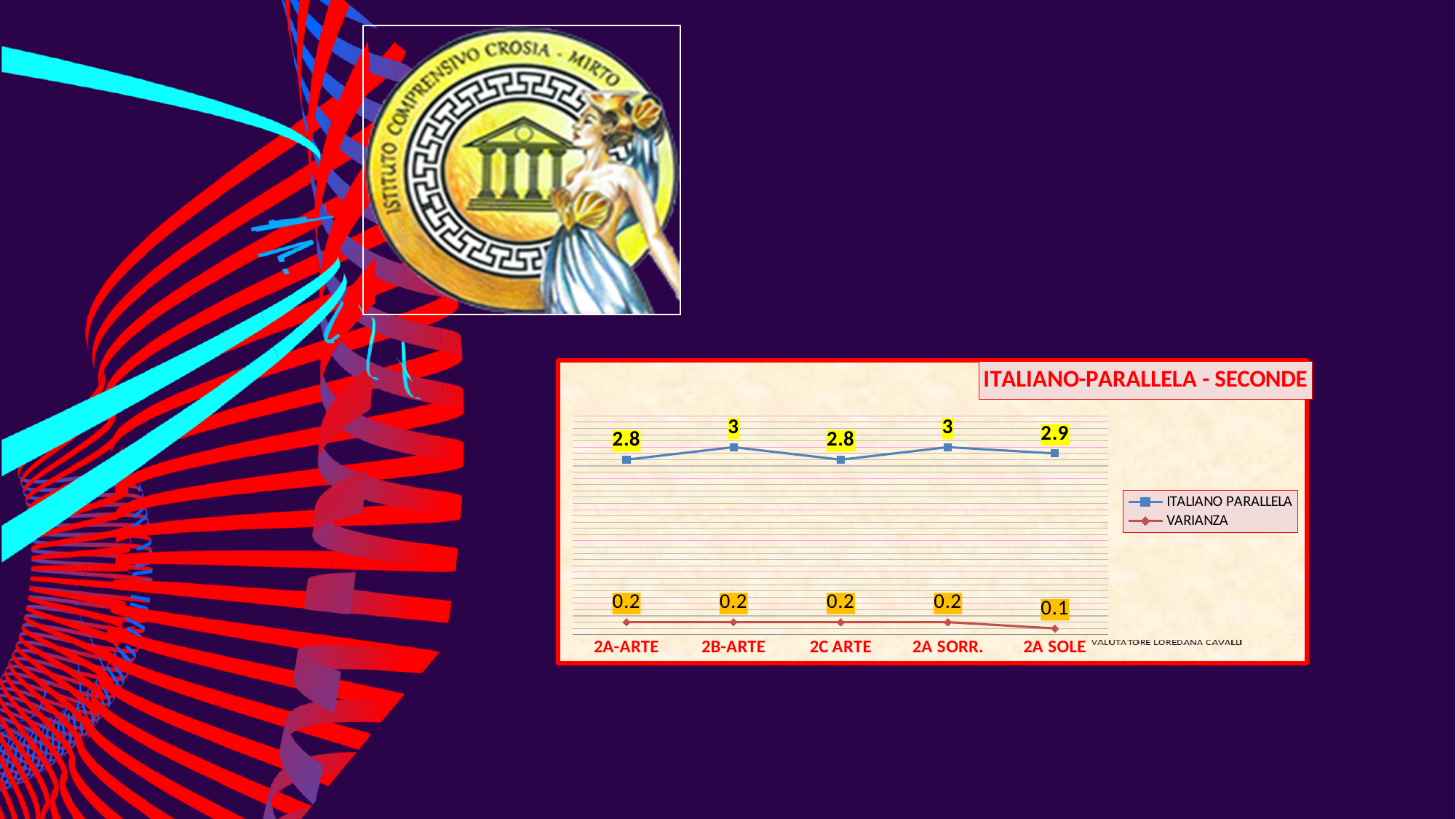
What is the difference between the ITALIANO PARALLELA values for 2B-ARTE and 2A-ARTE? 0.2 Which category has the lowest VARIANZA value? 2A SOLE Which is larger, the ITALIANO PARALLELA value for 2A SORR. or for 2C ARTE? 2A SORR. What is the ITALIANO PARALLELA value for 2A SOLE? 2.9 What is the ITALIANO PARALLELA value for 2B-ARTE? 3 What is the VARIANZA value for 2A SOLE? 0.1 Which series is drawn in blue? ITALIANO PARALLELA How many categories are shown on the x axis? 5 What is the title of the chart? ITALIANO-PARALLELA - SECONDE What is the VARIANZA value for 2C ARTE? 0.2 What kind of chart is shown? Line chart How many series does the legend list? 2